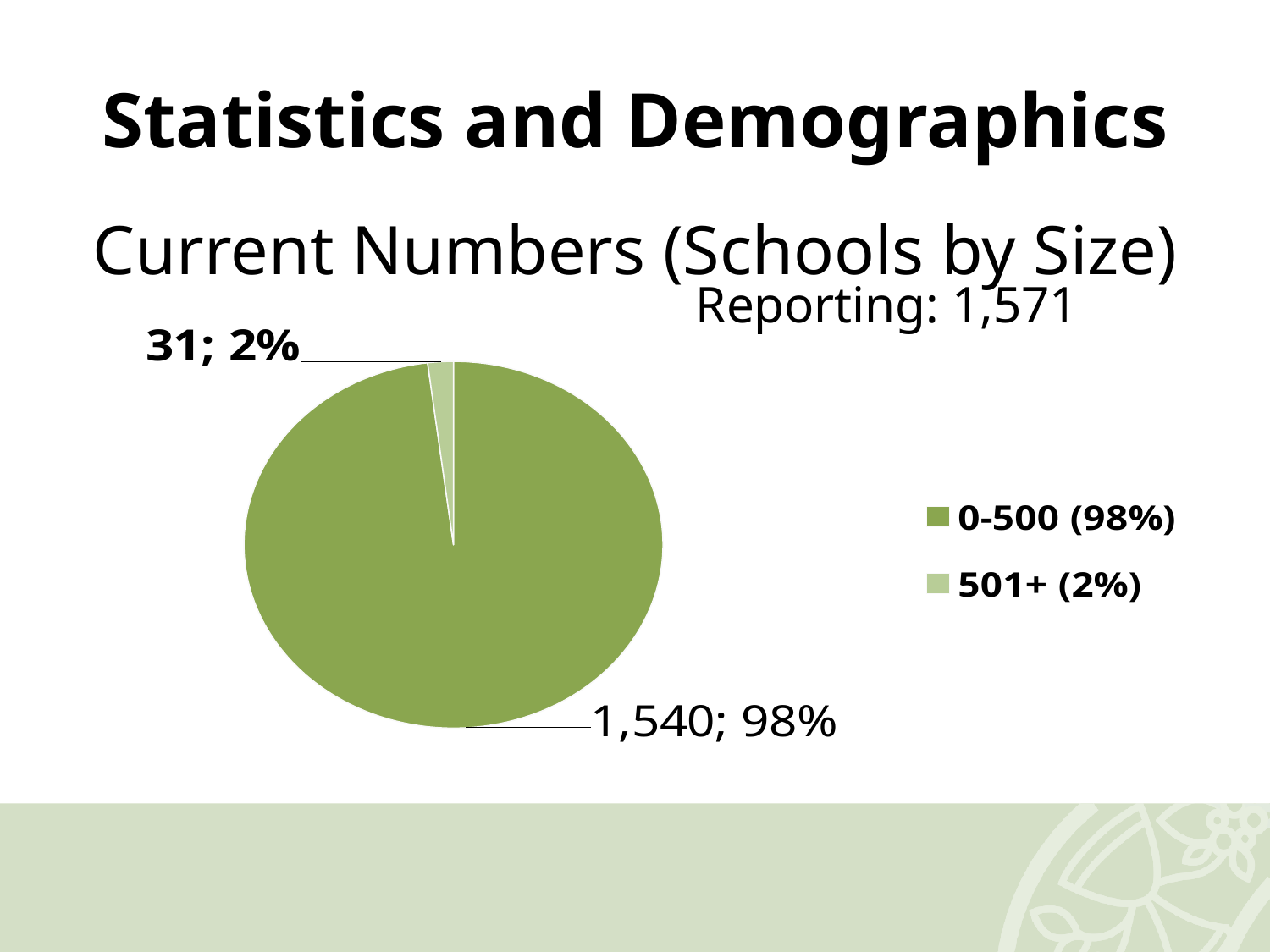
How many categories does the pie chart show? 2 How many schools are in the 501+ size category? 31 Which school size category has the largest slice of the pie? 0-500 What kind of chart is shown on the slide? pie chart How many entries does the legend list? 2 What is the total number of schools reporting, as stated on the slide? 1,571 What share of the pie does the 0-500 category represent? 98% What share of the pie does the 501+ category represent? 2% How many schools are in the 0-500 size category? 1,540 Which category has more schools, 0-500 or 501+? 0-500 Which school size category has the smallest slice of the pie? 501+ What is the difference between the number of schools in the 0-500 category and the 501+ category? 1,509